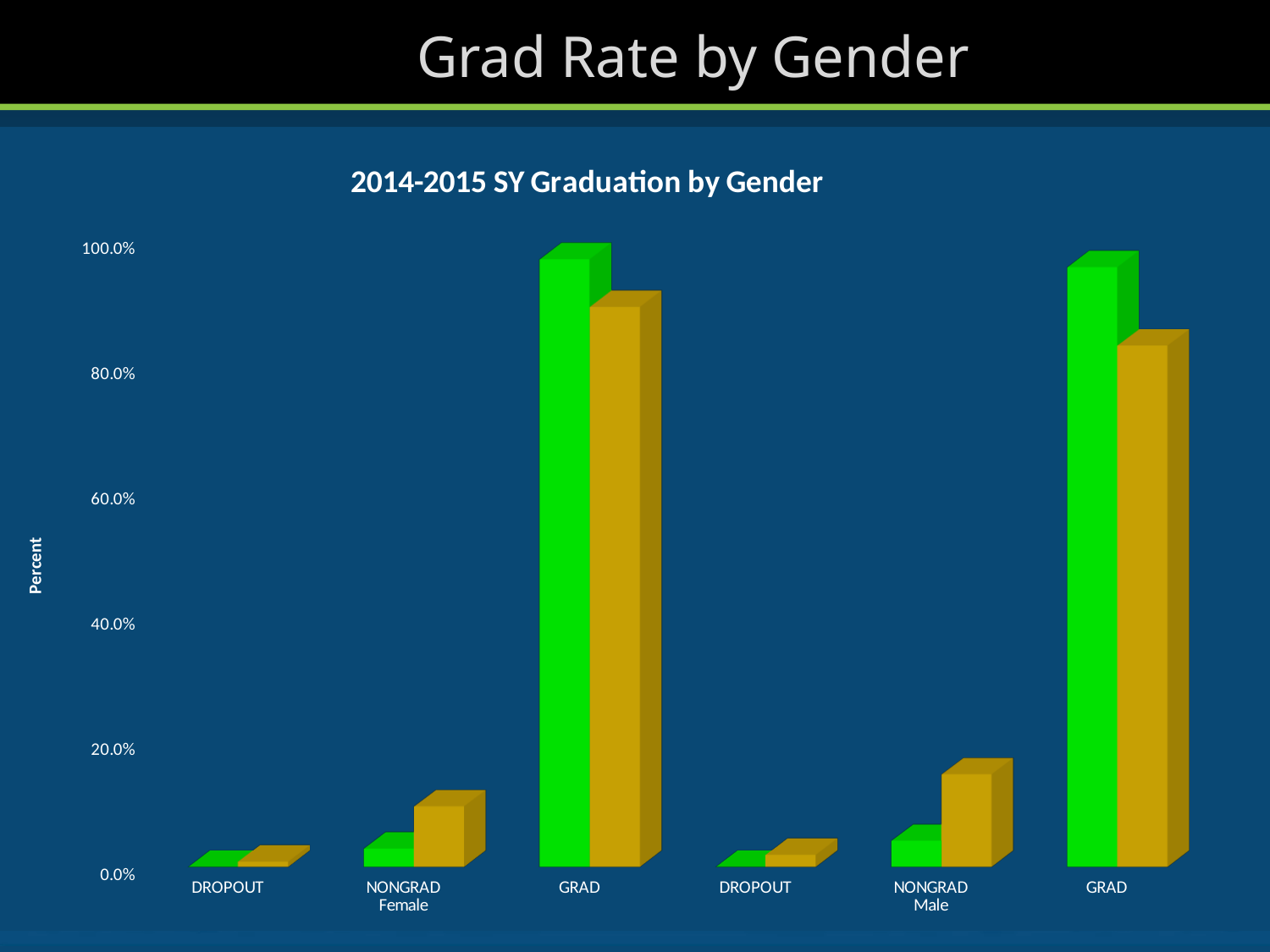
Which category has the tallest bars in the chart? GRAD For Male NONGRAD, which bar is taller, the green bar or the gold bar? the gold bar Is the value of the gold bar for Male GRAD greater or less than 80.0%? greater Which category has the shortest bars for Female? DROPOUT Is the value of the gold bar for Male NONGRAD greater or less than 20.0%? less Is the value of the gold bar for Female NONGRAD greater or less than 20.0%? less What is the title of the chart? 2014-2015 SY Graduation by Gender What kind of chart is shown on the slide? bar chart How many categories are shown along the x axis of the chart? 6 What is the label on the vertical axis of the chart? Percent For Female GRAD, which bar is taller, the green bar or the gold bar? the green bar